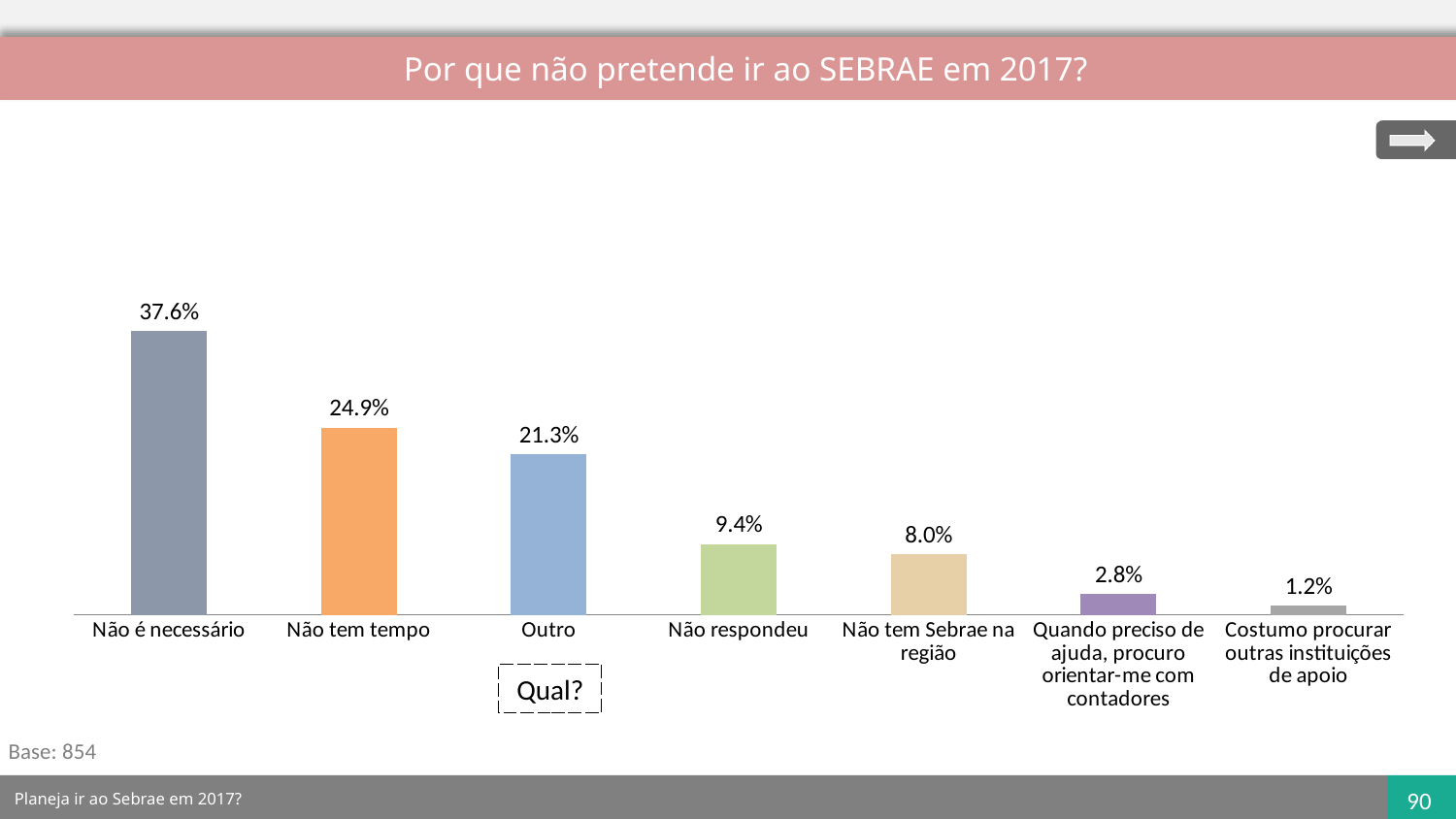
Which category has the lowest value? Costumo procurar outras instituições de apoio What is the value for "Não tem Sebrae na região"? 8.0% What is the title of the chart? Por que não pretende ir ao SEBRAE em 2017? How many categories are shown in the chart? 7 What is the difference between the values for "Não é necessário" and "Não tem tempo"? 12.7% What is the value for "Não é necessário"? 37.6% Which is larger, the value for "Não respondeu" or the value for "Não tem Sebrae na região"? Não respondeu What is the value for "Outro"? 21.3% Which category has the highest value? Não é necessário What is the value for "Não respondeu"? 9.4% What kind of chart is shown on the slide? Bar chart What is the value for "Não tem tempo"? 24.9%